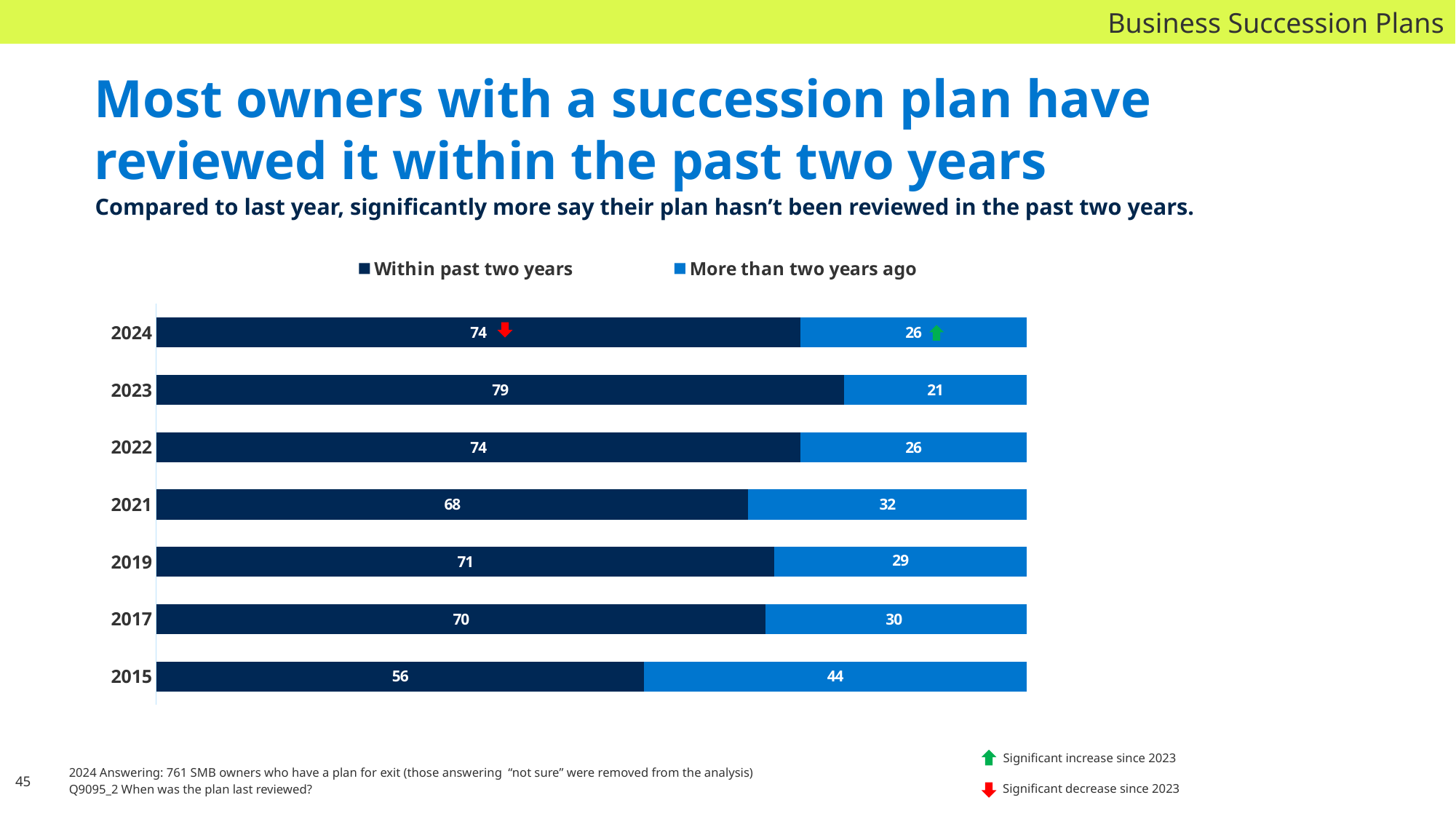
Which is larger: the "More than two years ago" value for 2019 or for 2017? 2017 What is the value for "Within past two years" in 2024? 74 What is the total of the stacked bar for 2022? 100 How many years are shown on the chart? 7 Which year has the highest value for "Within past two years"? 2023 How many series does the legend list? 2 What is the difference between the "Within past two years" values for 2023 and 2024? 5 What kind of chart is shown on the slide? Stacked bar chart What is the value for "More than two years ago" in 2021? 32 What does the red arrow next to the 2024 value indicate? Significant decrease since 2023 Which year has the lowest value for "Within past two years"? 2015 What is the value for "More than two years ago" in 2015? 44